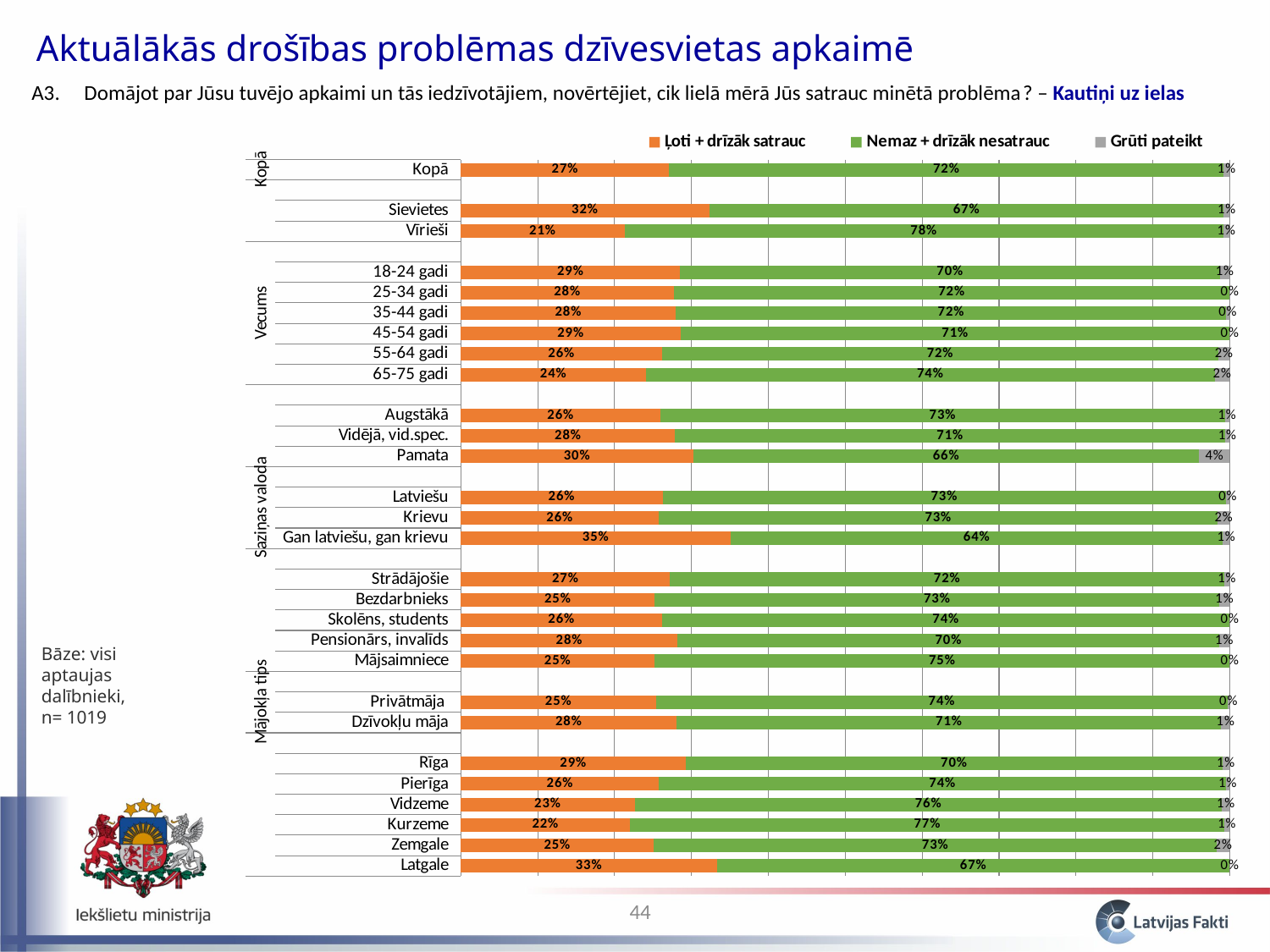
How many categories are plotted in the chart? 28 What is the total of the stacked bar for 'Pamata'? 100% What is the 'Grūti pateikt' value for 'Pamata'? 4% Which has a larger 'Ļoti + drīzāk satrauc' value, 'Latgale' or 'Kurzeme'? Latgale Which category has the highest 'Ļoti + drīzāk satrauc' value? Gan latviešu, gan krievu Which category has the lowest 'Ļoti + drīzāk satrauc' value? Vīrieši Which colour represents the 'Grūti pateikt' series? Grey How many series does the legend list? 3 What percentage of respondents in the 'Kopā' category answered 'Ļoti + drīzāk satrauc'? 27% What is the 'Nemaz + drīzāk nesatrauc' value for 'Vīrieši'? 78% What is the difference between the 'Ļoti + drīzāk satrauc' values for 'Sievietes' and 'Vīrieši'? 11 percentage points What kind of chart is shown on the slide? Stacked bar chart